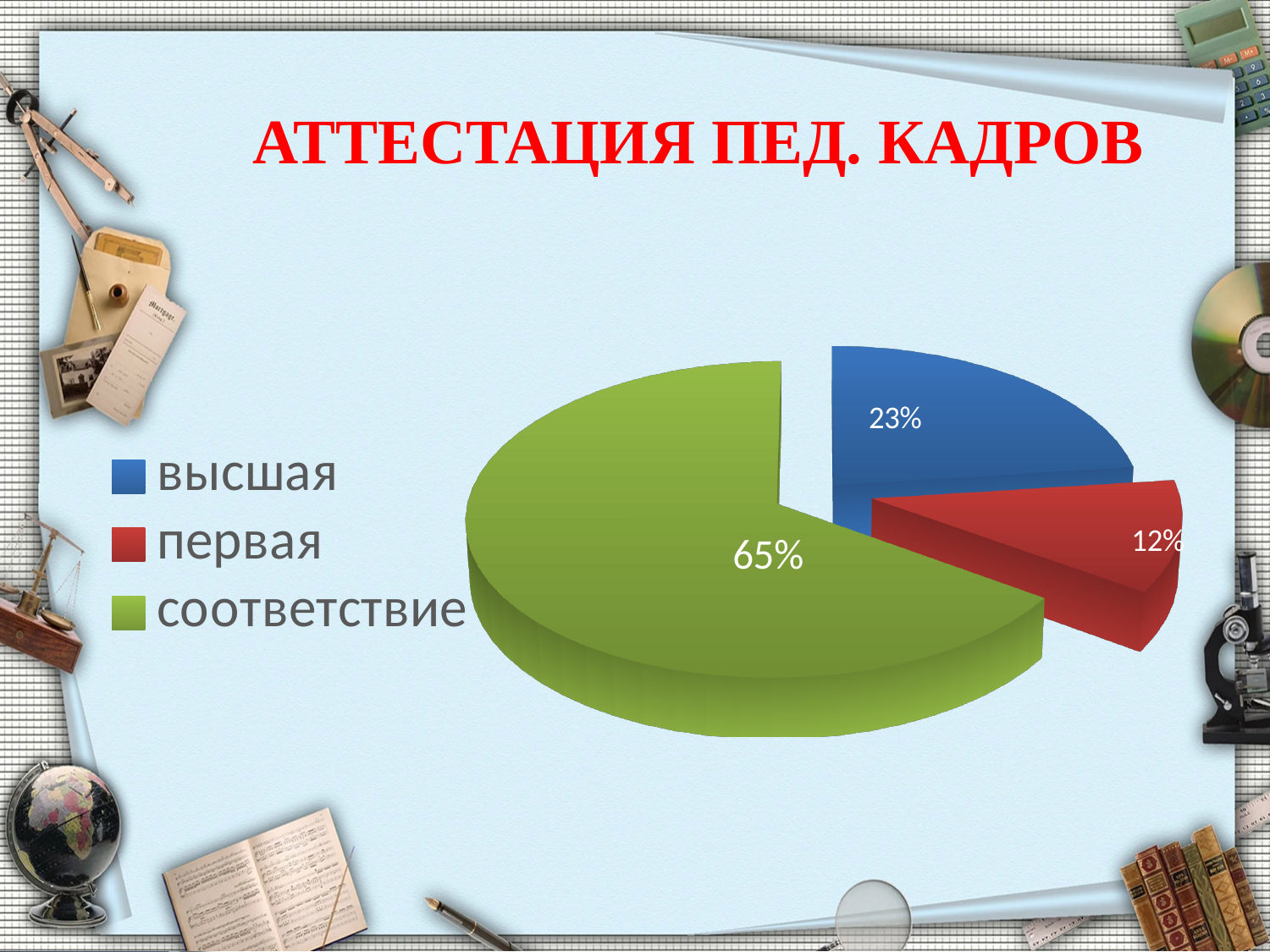
What colour is the 'первая' slice? red Which category has the largest share of the pie? соответствие What kind of chart is shown on the slide? pie chart What is the title of the slide? АТТЕСТАЦИЯ ПЕД. КАДРОВ What percentage is shown for the 'соответствие' slice? 65% How many slices does the pie chart have? 3 What is the difference in percentage points between 'соответствие' and 'высшая'? 42 Which is larger, the share for 'высшая' or the share for 'первая'? высшая Which category has the smallest share of the pie? первая What percentage is shown for the 'высшая' slice? 23% How many entries does the legend list? 3 What percentage is shown for the 'первая' slice? 12%